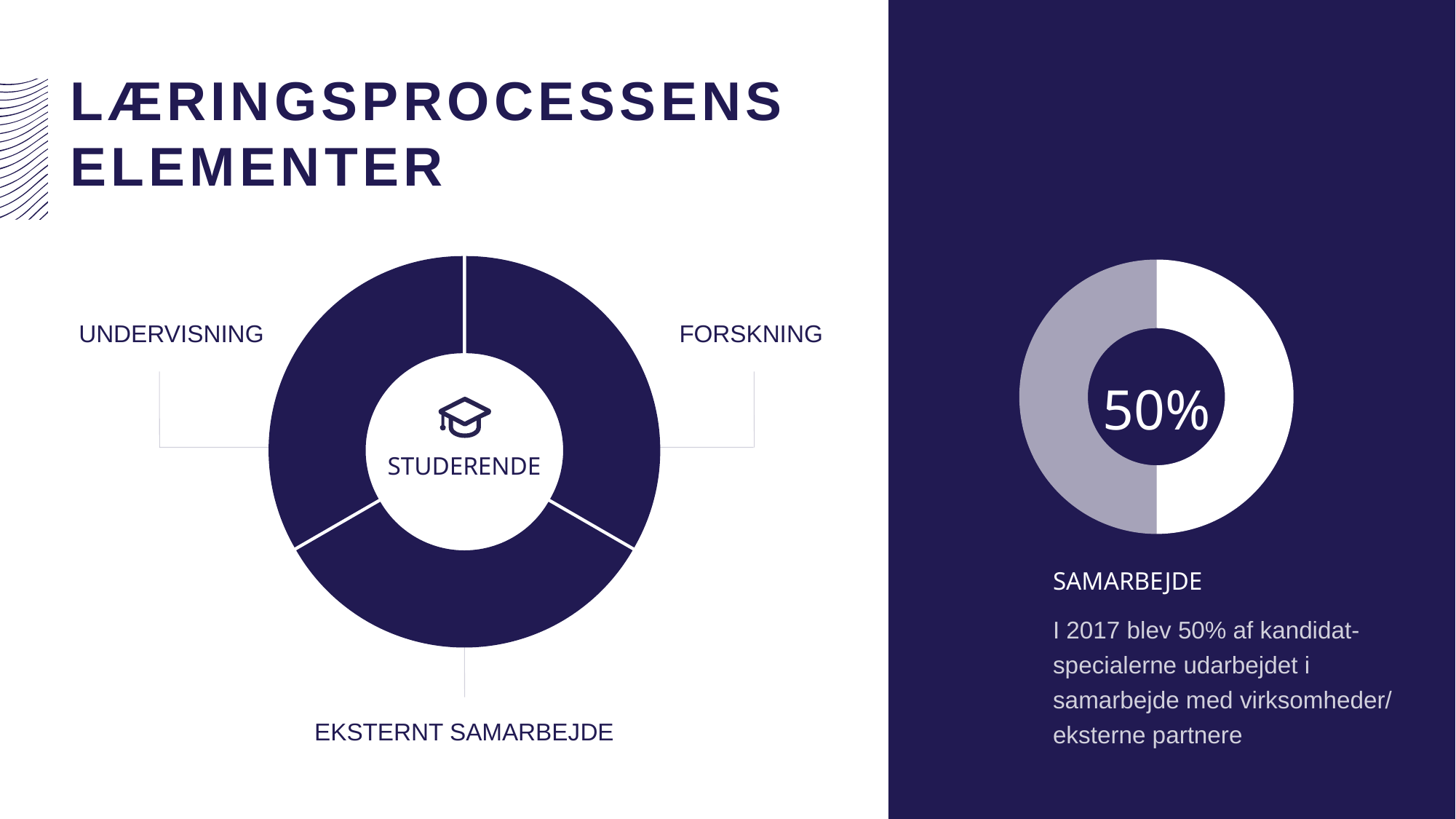
On the right-hand donut chart, what share of the ring does the grey segment represent? 50% How many segments does the left-hand donut diagram have? 3 On the right-hand donut chart, is the grey segment greater or less than 75% of the ring? less On the left-hand donut diagram, what word is written in the centre? STUDERENDE What kind of chart is shown on the right-hand side of the slide? Donut chart On the left-hand donut diagram, which label is attached to the upper-left segment? UNDERVISNING On the right-hand donut chart, what percentage is shown in the centre? 50% On the left-hand donut diagram, which label is attached to the upper-right segment? FORSKNING On the left-hand donut diagram, which label is attached to the bottom segment? EKSTERNT SAMARBEJDE According to the text beside the right-hand donut chart, in which year were 50% of the master's theses produced in collaboration with companies/external partners? 2017 What kind of chart is the left-hand diagram with UNDERVISNING, FORSKNING and EKSTERNT SAMARBEJDE? Donut chart What label appears directly below the right-hand donut chart? SAMARBEJDE